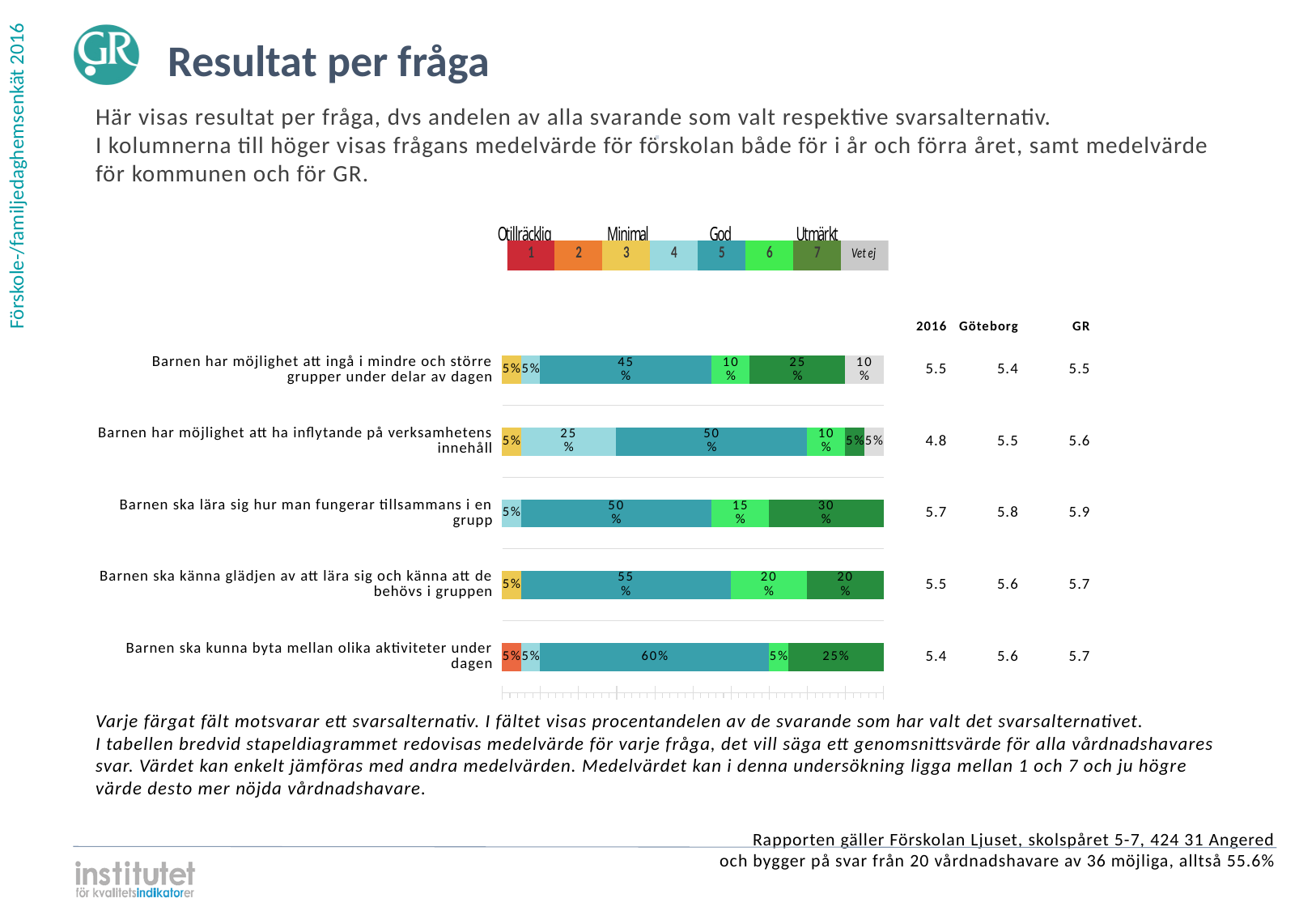
What is the Göteborg mean value for 'Barnen ska lära sig hur man fungerar tillsammans i en grupp'? 5.8 What is the 2016 mean value for 'Barnen har möjlighet att ha inflytande på verksamhetens innehåll'? 4.8 What percentage chose 'Vet ej' for 'Barnen har möjlighet att ingå i mindre och större grupper under delar av dagen'? 10% Which question has the largest share of respondents choosing rating 5 (teal segment)? Barnen ska kunna byta mellan olika aktiviteter under dagen How many entries does the legend above the chart list? 8 What is the difference between the GR mean and the 2016 mean for 'Barnen har möjlighet att ha inflytande på verksamhetens innehåll'? 0.8 What percentage of respondents chose rating 5 (God, teal) for 'Barnen ska kunna byta mellan olika aktiviteter under dagen'? 60% What percentage chose rating 7 (dark green) for 'Barnen ska lära sig hur man fungerar tillsammans i en grupp'? 30% How many questions (categories) are shown in the bar chart? 5 Which question has the lowest 2016 mean value? Barnen har möjlighet att ha inflytande på verksamhetens innehåll For 'Barnen ska känna glädjen av att lära sig och känna att de behövs i gruppen', which is larger: the share choosing rating 5 or the share choosing rating 6? Rating 5 (55%) What kind of chart is used to show the results per question? Stacked bar chart